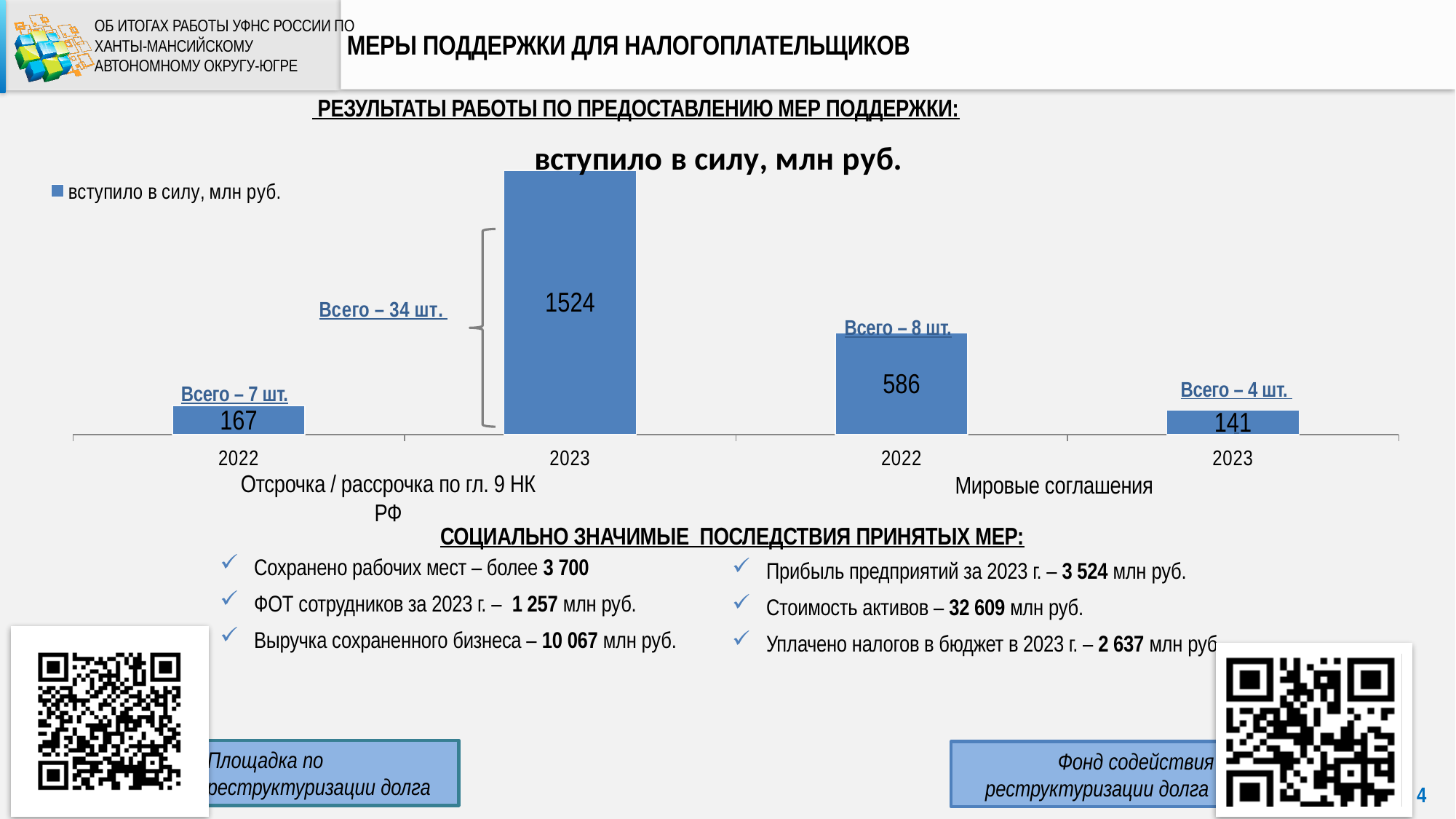
Which bar has the highest value? 2023, Отсрочка / рассрочка по гл. 9 НК РФ What is the difference between the 2023 and 2022 values under "Отсрочка / рассрочка по гл. 9 НК РФ"? 1357 Which is larger: the 2022 value under "Мировые соглашения" or the 2022 value under "Отсрочка / рассрочка по гл. 9 НК РФ"? 2022 under Мировые соглашения What type of chart is shown on the slide? Bar chart Which bar has the lowest value? 2023, Мировые соглашения What is the value for 2022 under "Отсрочка / рассрочка по гл. 9 НК РФ"? 167 How many bars are plotted in the chart? 4 What is the value for 2023 under "Отсрочка / рассрочка по гл. 9 НК РФ"? 1524 What is the value for 2022 under "Мировые соглашения"? 586 How many series does the legend list? 1 What is the difference between the 2022 and 2023 values under "Мировые соглашения"? 445 What is the value for 2023 under "Мировые соглашения"? 141